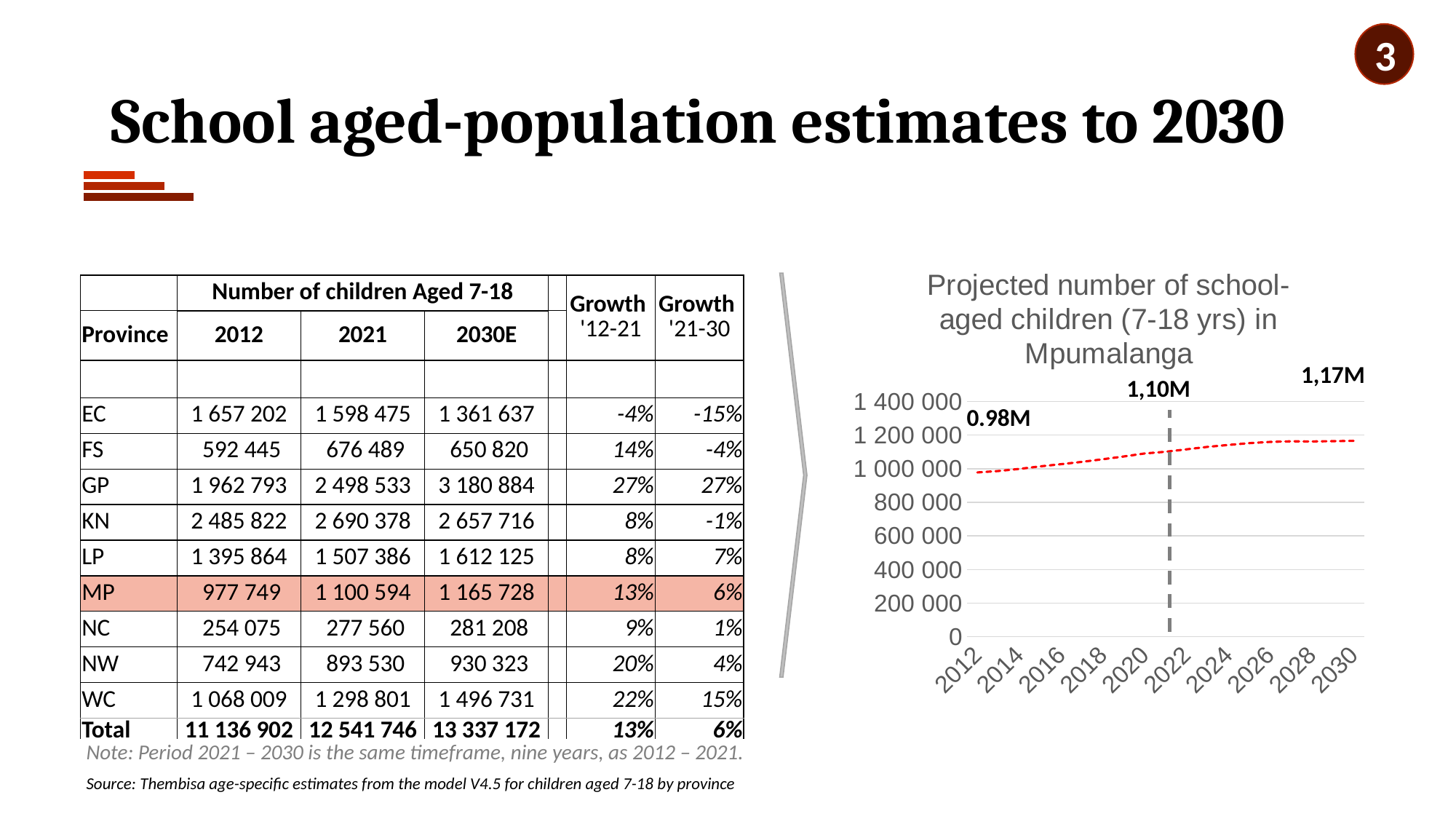
In the chart on the right, what value is labelled at the start of the line in 2012? 0.98M In the chart on the right, is the value for 2020 greater or less than 800 000? greater In the chart on the right, what value is labelled near the dashed vertical line? 1,10M In the chart on the right, does the projected number of school-aged children rise or fall from 2012 to 2030? rise In the chart on the right, which year has the highest projected number of school-aged children? 2030 In the chart on the right, which is larger, the value for 2012 or the value for 2030? 2030 What kind of chart is shown on the right of the slide? line chart In the chart on the right, is the value for 2030 greater or less than 1 000 000? greater What is the title of the chart on the right of the slide? Projected number of school-aged children (7-18 yrs) in Mpumalanga How many year labels are shown on the x axis of the chart on the right? 10 In the chart on the right, which year has the lowest projected number of school-aged children? 2012 In the chart on the right, what value is labelled at the end of the line in 2030? 1,17M